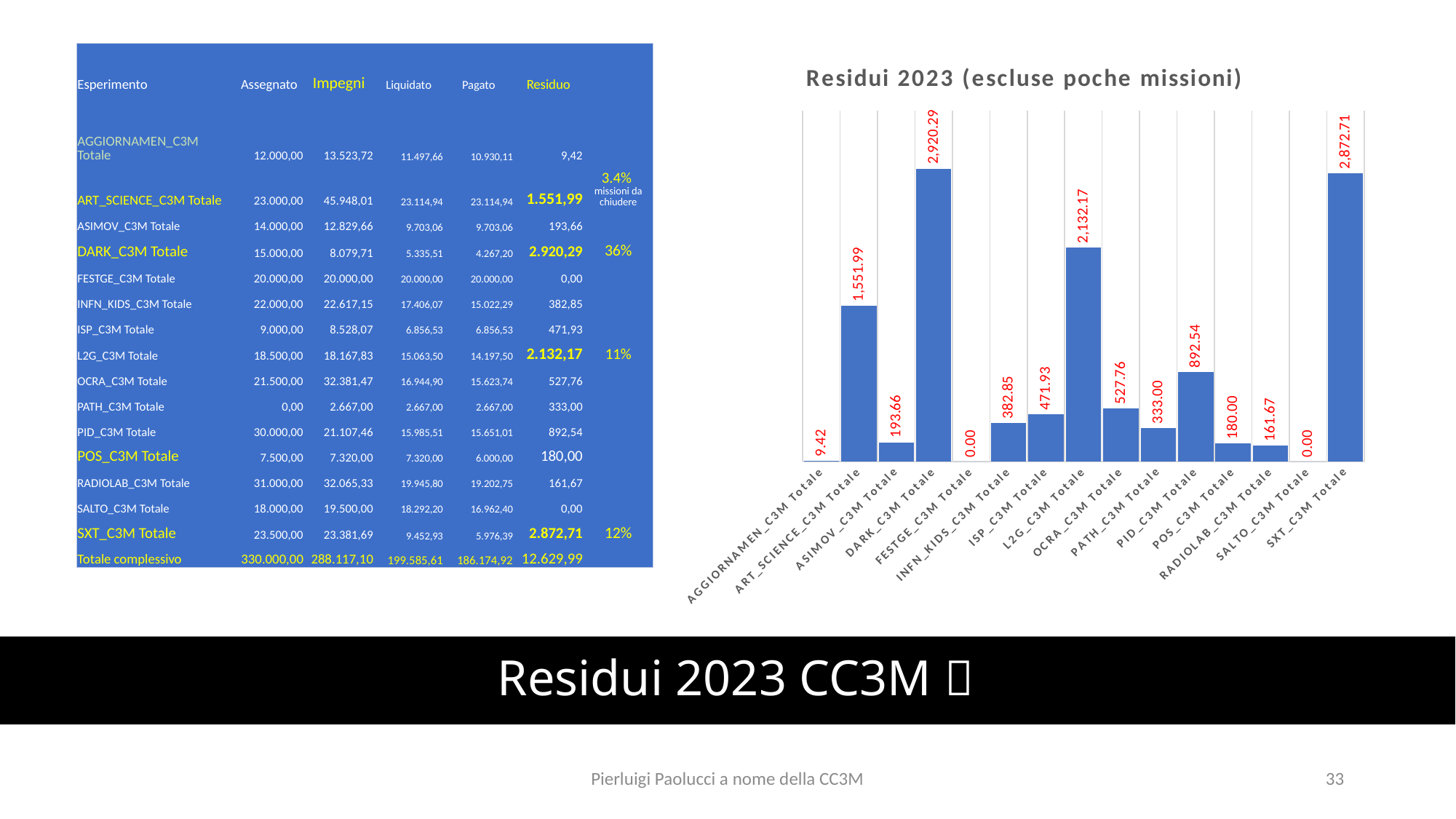
What is the value for AGGIORNAMEN_C3M Totale in the chart? 9.42 What colour are the bars in the chart? blue Which categories have a value of 0.00 in the chart? FESTGE_C3M Totale and SALTO_C3M Totale Which is larger, the value for ISP_C3M Totale or the value for INFN_KIDS_C3M Totale? ISP_C3M Totale What is the title of the chart? Residui 2023 (escluse poche missioni) What is the value for DARK_C3M Totale in the chart? 2,920.29 How many categories are plotted in the chart? 15 What is the difference between the values for DARK_C3M Totale and SXT_C3M Totale? 47.58 Which category has the highest value in the chart? DARK_C3M Totale What kind of chart is shown on the slide? bar chart What is the value for PID_C3M Totale in the chart? 892.54 What is the value for L2G_C3M Totale in the chart? 2,132.17